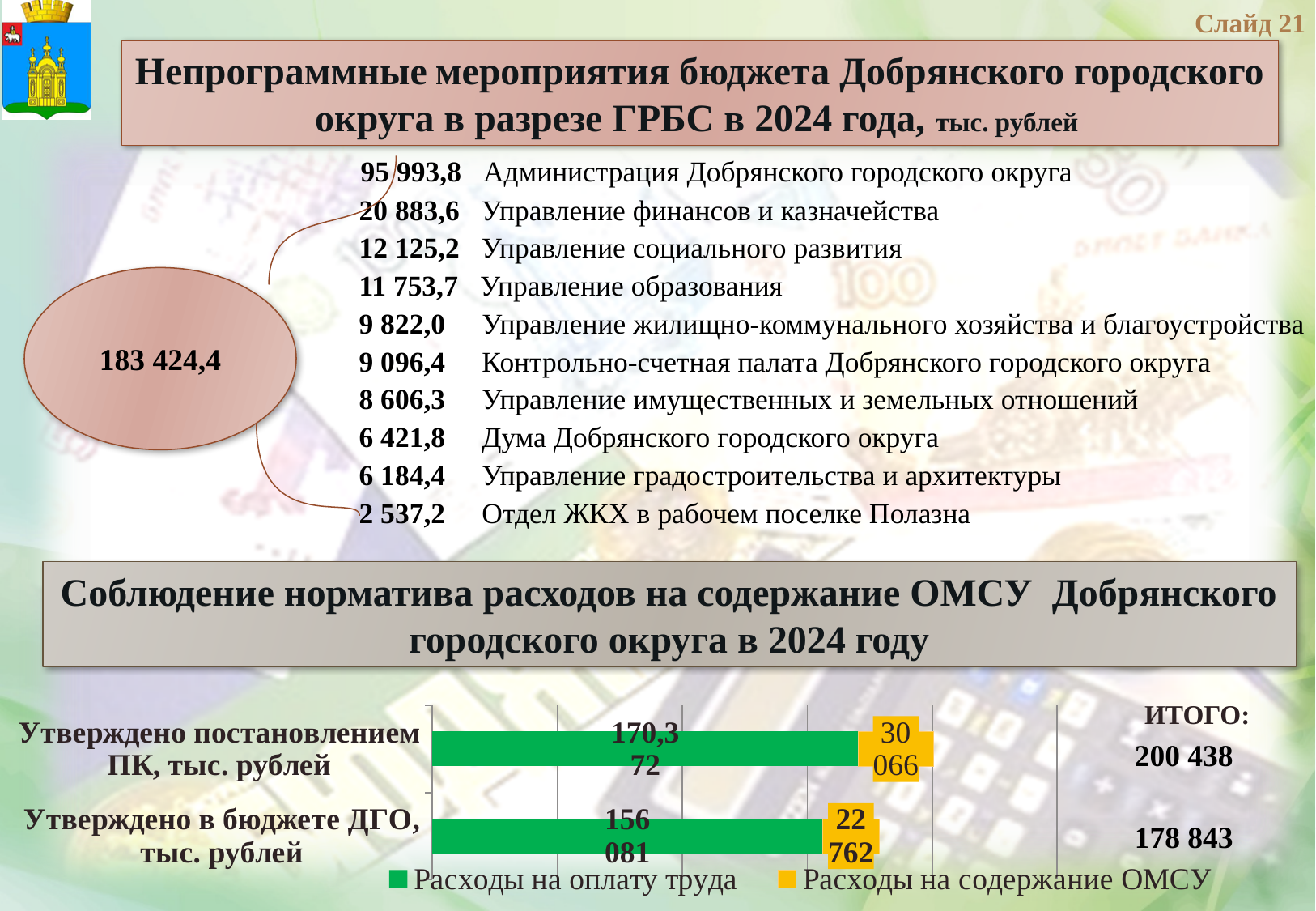
In the bar chart, what is the value of 'Расходы на оплату труда' for 'Утверждено в бюджете ДГО, тыс. рублей'? 156 081 In the bar chart, what is the difference between the 'Расходы на содержание ОМСУ' values for 'Утверждено постановлением ПК' and 'Утверждено в бюджете ДГО'? 7 304 In the bar chart, what is the value of 'Расходы на содержание ОМСУ' for 'Утверждено в бюджете ДГО, тыс. рублей'? 22 762 In the bar chart, which series is shown in yellow? Расходы на содержание ОМСУ How many series does the legend of the bar chart list? 2 How many categories does the bar chart show? 2 What kind of chart is shown at the bottom of the slide? bar chart In the bar chart, which series is shown in green? Расходы на оплату труда In the bar chart, what is the total (ИТОГО) for 'Утверждено постановлением ПК, тыс. рублей'? 200 438 In the bar chart, which category has the larger value for 'Расходы на содержание ОМСУ': 'Утверждено постановлением ПК' or 'Утверждено в бюджете ДГО'? Утверждено постановлением ПК In the bar chart, what is the value of 'Расходы на содержание ОМСУ' for 'Утверждено постановлением ПК, тыс. рублей'? 30 066 In the bar chart, what is the total (ИТОГО) for 'Утверждено в бюджете ДГО, тыс. рублей'? 178 843